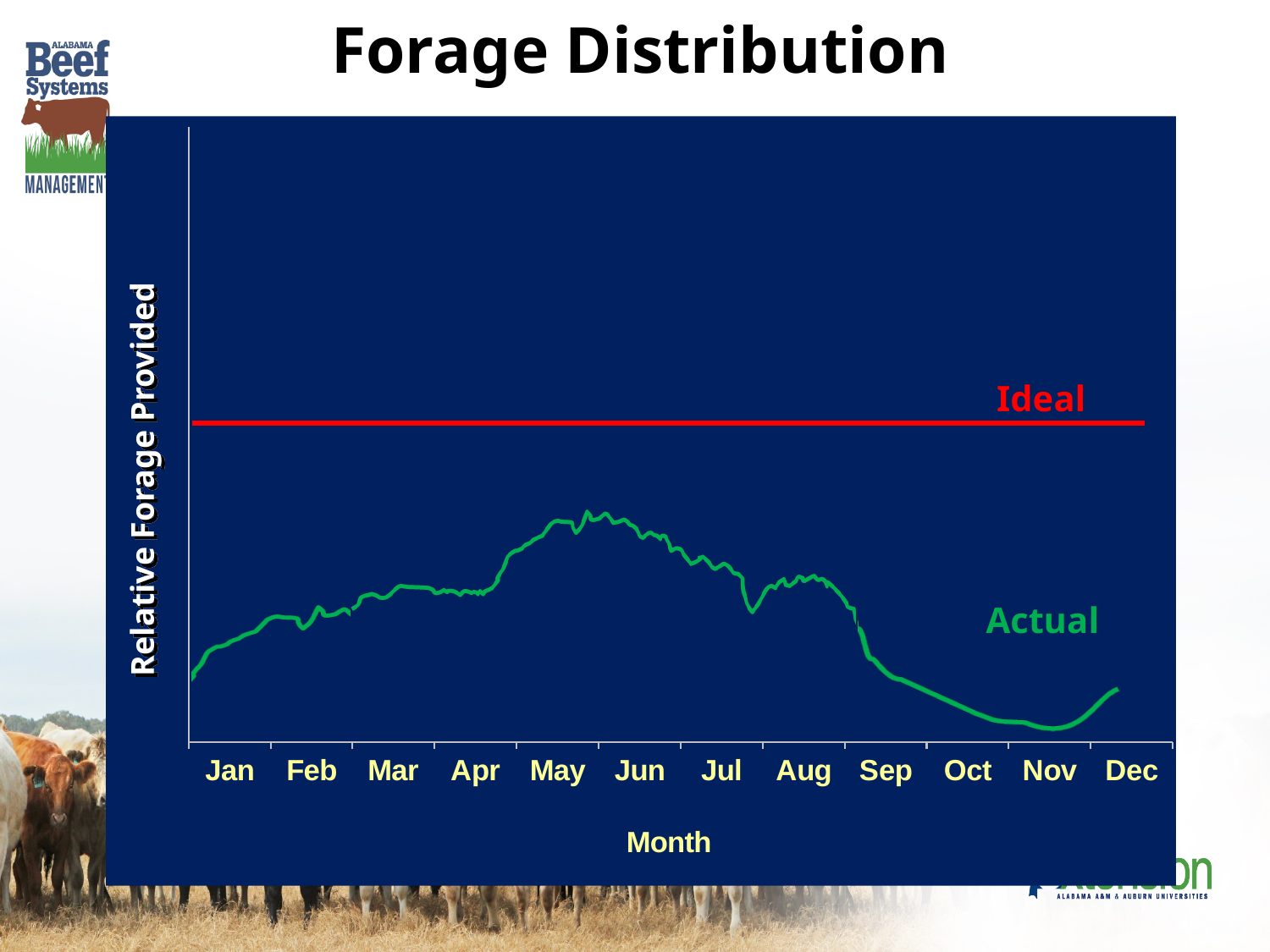
What kind of chart is shown on the slide? line chart How many series are plotted on the Forage Distribution chart? 2 How many months are labelled along the x axis of the chart? 12 Does the Actual line ever rise above the Ideal line? No In which month does the Actual line reach its lowest point? Nov Which line is higher in January, Ideal or Actual? Ideal Does the Actual line rise or fall from Jan to May? rise Does the Ideal line rise, fall, or stay flat across the months? stay flat What is the title of the chart? Forage Distribution Does the Actual line rise or fall from Jun to Nov? fall What is the label on the y axis of the chart? Relative Forage Provided